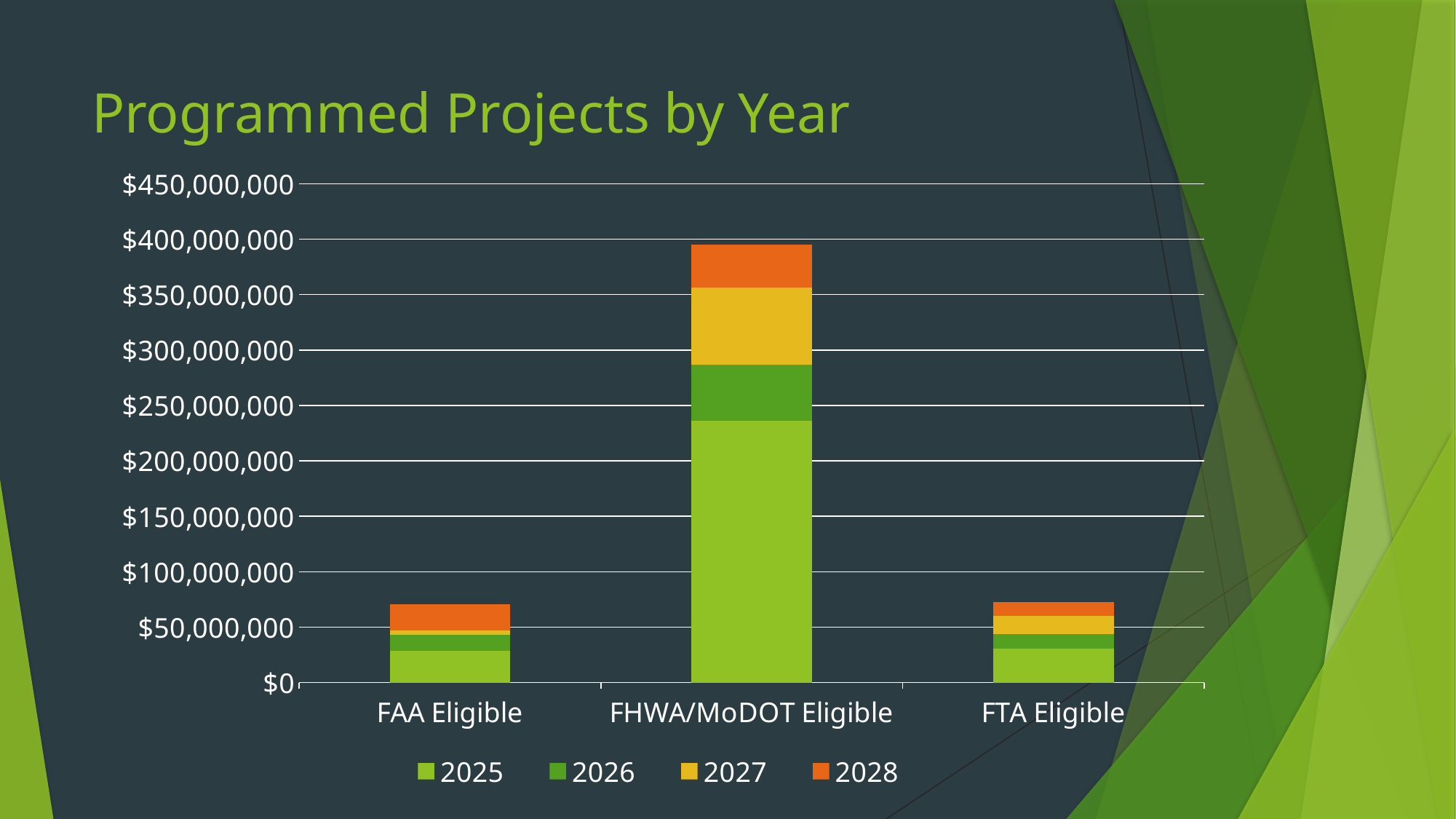
Is the total for FHWA/MoDOT Eligible greater or less than $350,000,000? greater Is the total for FHWA/MoDOT Eligible greater or less than $400,000,000? less Is the total for FTA Eligible greater or less than $50,000,000? greater How many series does the legend list? 4 Which series is shown in orange in the legend? 2028 Which category has the highest total stacked bar? FHWA/MoDOT Eligible What is the title of the chart? Programmed Projects by Year How many categories are shown on the x axis? 3 What kind of chart is shown on the slide? Stacked bar chart Which is larger, the total for FHWA/MoDOT Eligible or the total for FAA Eligible? FHWA/MoDOT Eligible